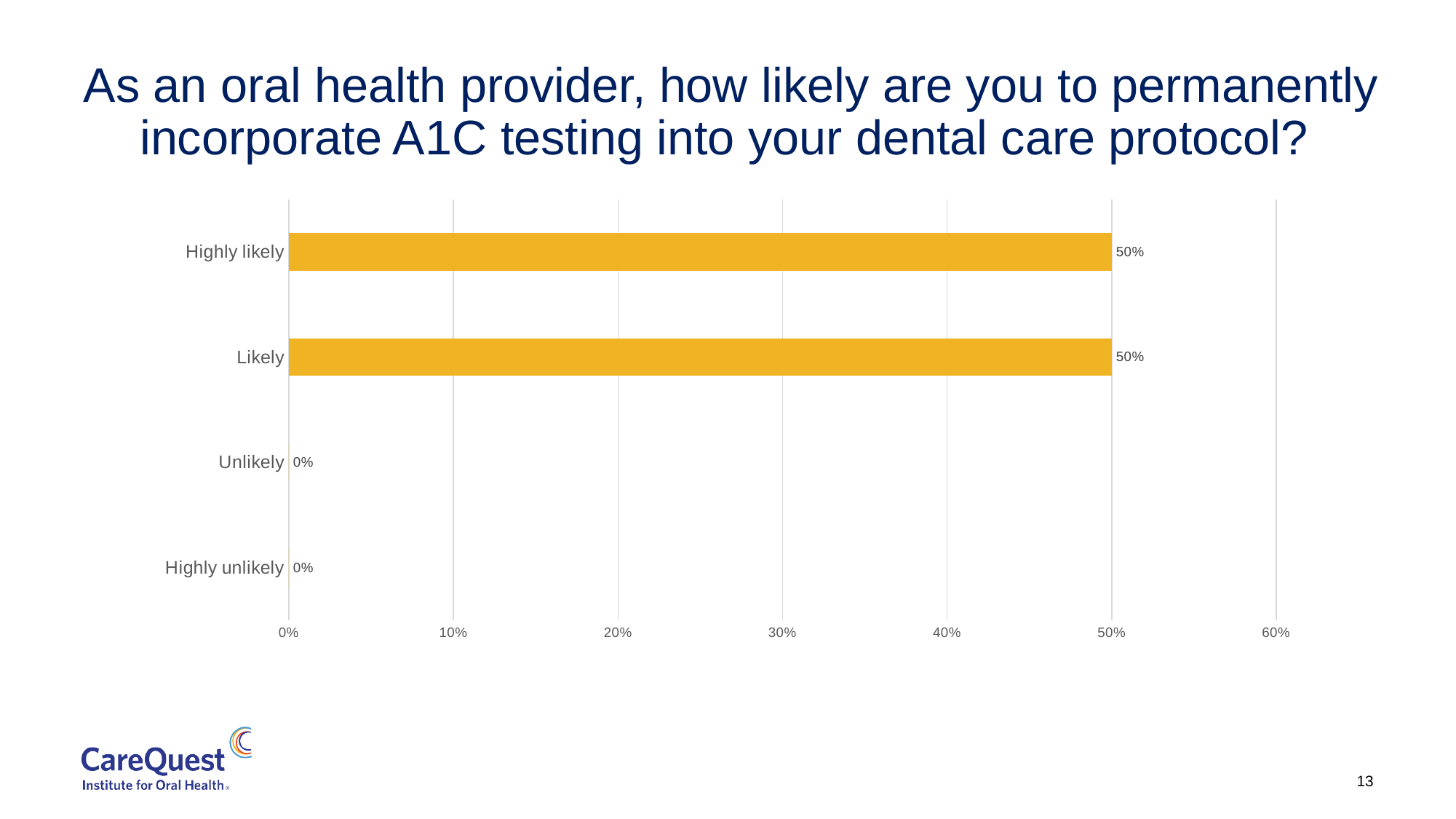
What is the total of the values for Highly likely and Likely? 100% What is the difference between the values for Highly likely and Unlikely? 50% What is the value for Highly likely? 50% What is the highest value shown on the x axis? 60% What is the value for Likely? 50% What colour are the bars in the chart? yellow Which is larger, the value for Likely or the value for Highly unlikely? Likely Is the value for Highly likely greater or less than 40%? greater What is the value for Highly unlikely? 0% What kind of chart is shown on the slide? bar chart What is the value for Unlikely? 0% How many categories are shown on the chart? 4